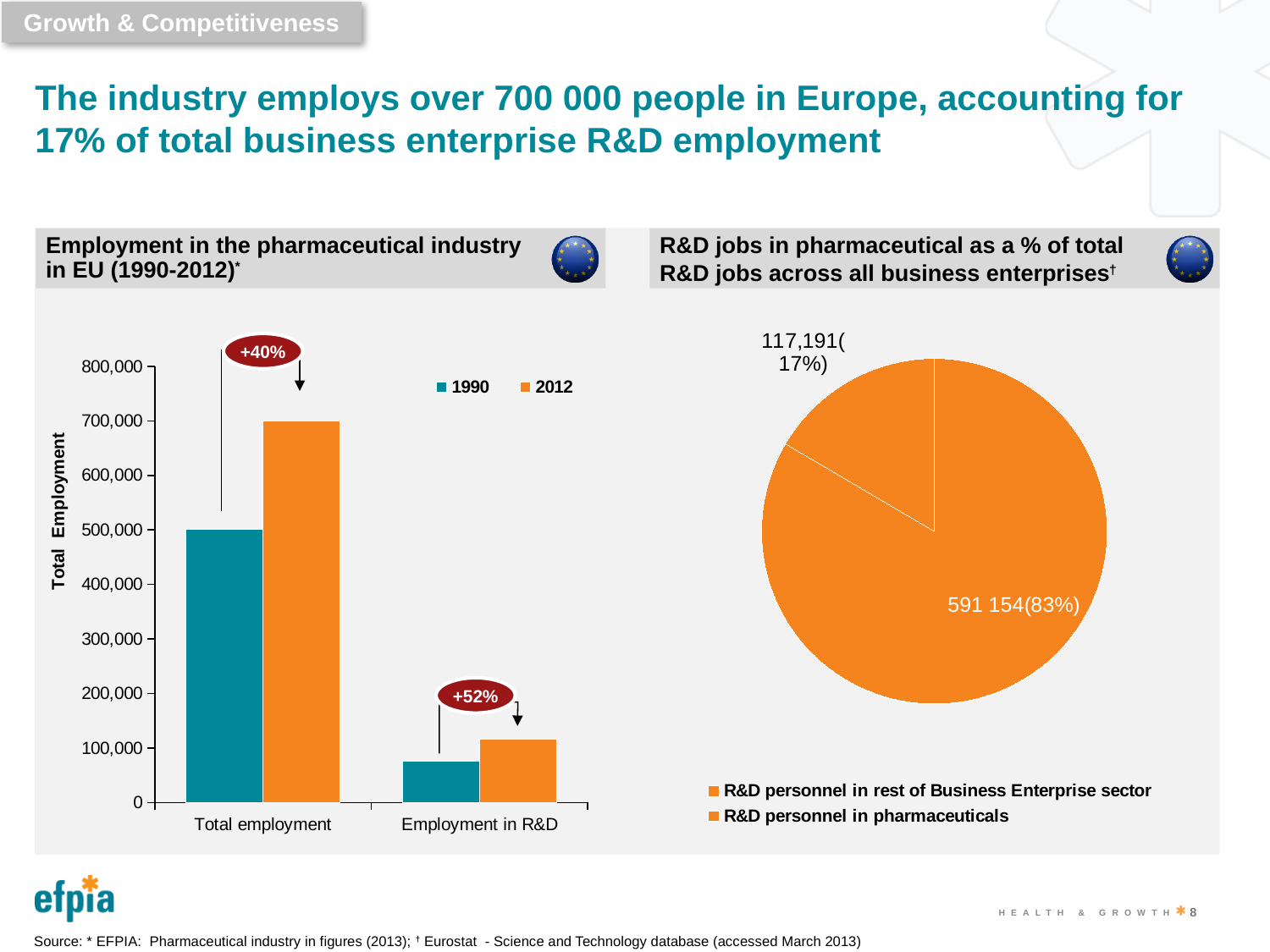
In the right pie chart, what value is shown for R&D personnel in rest of Business Enterprise sector? 591 154 In the right pie chart, which slice is the largest? R&D personnel in rest of Business Enterprise sector In the left bar chart, what percentage increase is annotated above the Total employment bars? +40% In the left bar chart, is the 1990 value for Employment in R&D greater or less than 100,000? less In the left bar chart, is the 2012 value for Total employment greater or less than 600,000? greater In the left bar chart, which is larger for Total employment: the 1990 bar or the 2012 bar? 2012 In the left bar chart, what percentage increase is annotated above the Employment in R&D bars? +52% In the right pie chart, what share of the pie is R&D personnel in pharmaceuticals? 17% In the left bar chart, how many categories are shown on the x axis? 2 What kind of chart is the right chart, 'R&D jobs in pharmaceutical as a % of total R&D jobs across all business enterprises'? pie chart What kind of chart is the left chart, 'Employment in the pharmaceutical industry in EU (1990-2012)'? bar chart In the left bar chart, how many series does the legend list? 2